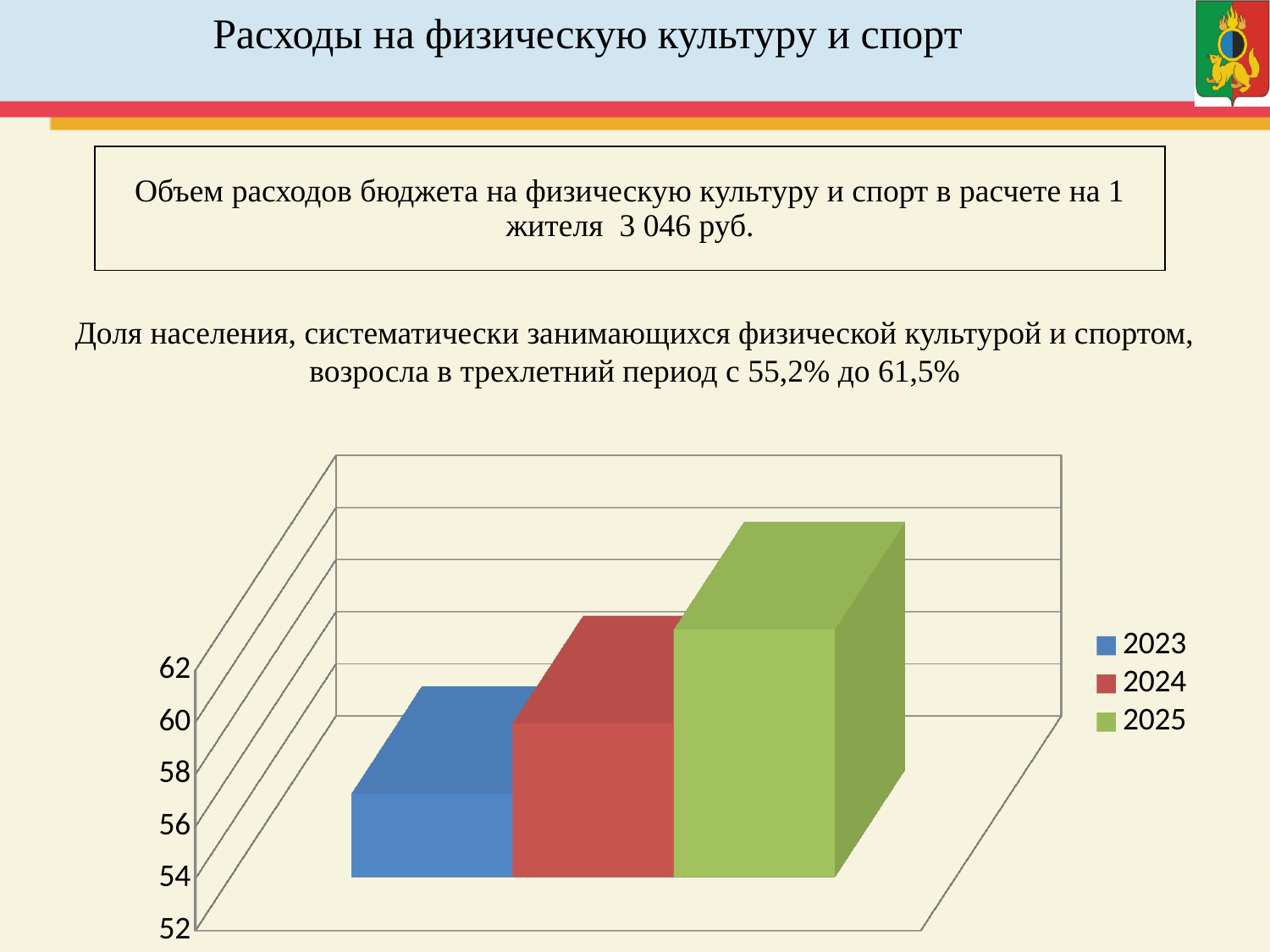
What kind of chart is shown on the slide? bar chart Do the bar values rise or fall from 2023 to 2025? rise Is the value for 2023 greater or less than 60? less What colour is the bar for 2025 in the chart? green Is the value for 2025 greater or less than 58? greater Which bar is taller, 2024 or 2023? 2024 Which year has the lowest bar in the chart? 2023 Which years are listed in the chart legend? 2023, 2024, 2025 How many series does the chart legend list? 3 How many bars are plotted in the chart? 3 Which bar is taller, 2024 or 2025? 2025 Which year has the highest bar in the chart? 2025